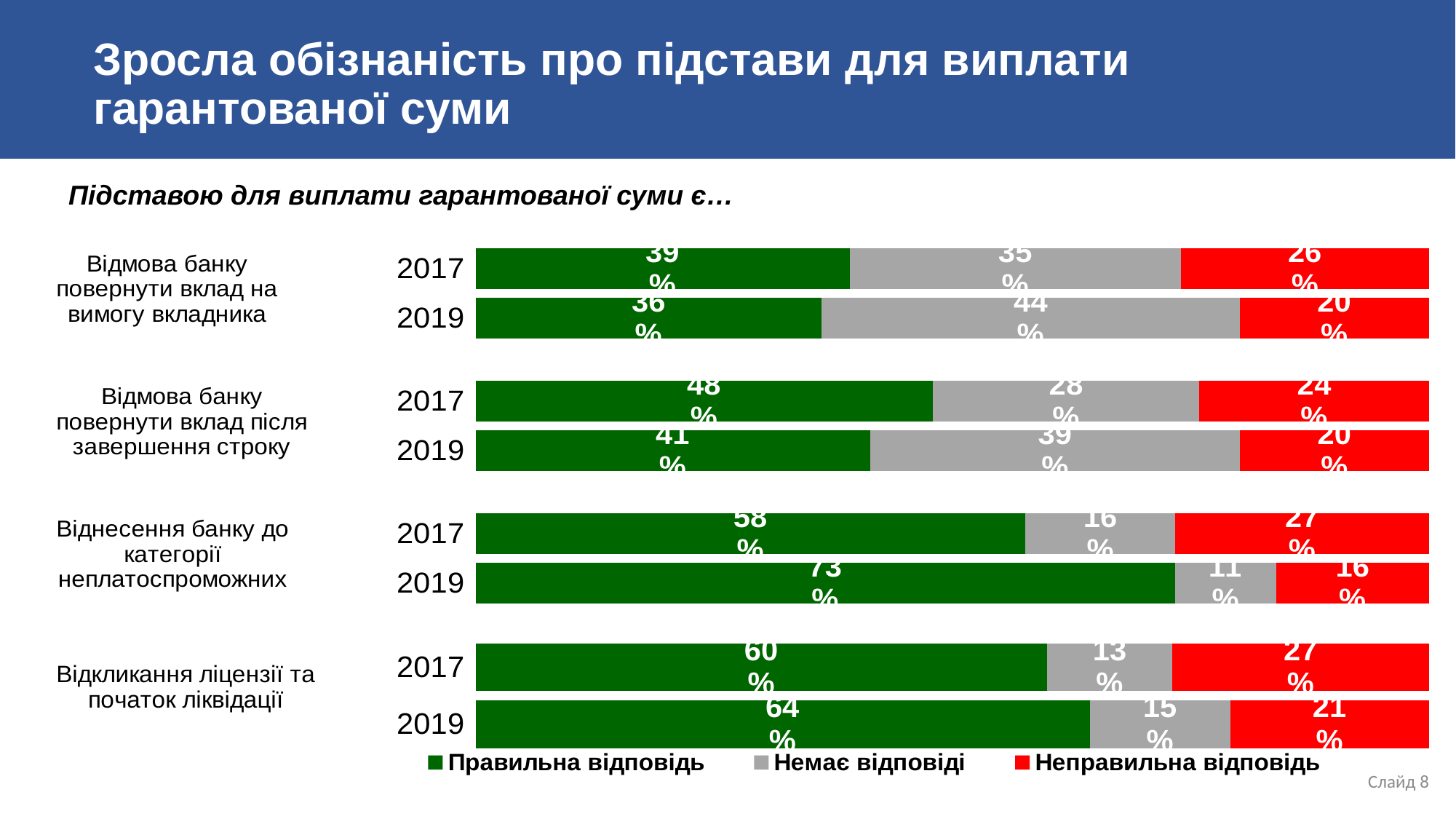
What kind of chart is shown on the slide? Stacked bar chart Which series is shown in red in the chart? Неправильна відповідь What is the share of incorrect answers (Неправильна відповідь) for 'Відкликання ліцензії та початок ліквідації' in 2017? 27% What is the share of 'Немає відповіді' for 'Відкликання ліцензії та початок ліквідації' in 2019? 15% How many series does the legend list? 3 Which bar has the lowest share of correct answers (Правильна відповідь)? Відмова банку повернути вклад на вимогу вкладника, 2019 Which bar has the highest share of correct answers (Правильна відповідь)? Віднесення банку до категорії неплатоспроможних, 2019 What is the share of 'Немає відповіді' for 'Відмова банку повернути вклад на вимогу вкладника' in 2019? 44% For 'Відмова банку повернути вклад після завершення строку', which year has the larger share of correct answers, 2017 or 2019? 2017 What is the share of correct answers (Правильна відповідь) for 'Віднесення банку до категорії неплатоспроможних' in 2019? 73% How many bars are plotted in the chart? 8 By how many percentage points did the share of correct answers for 'Віднесення банку до категорії неплатоспроможних' change from 2017 to 2019? 15 percentage points